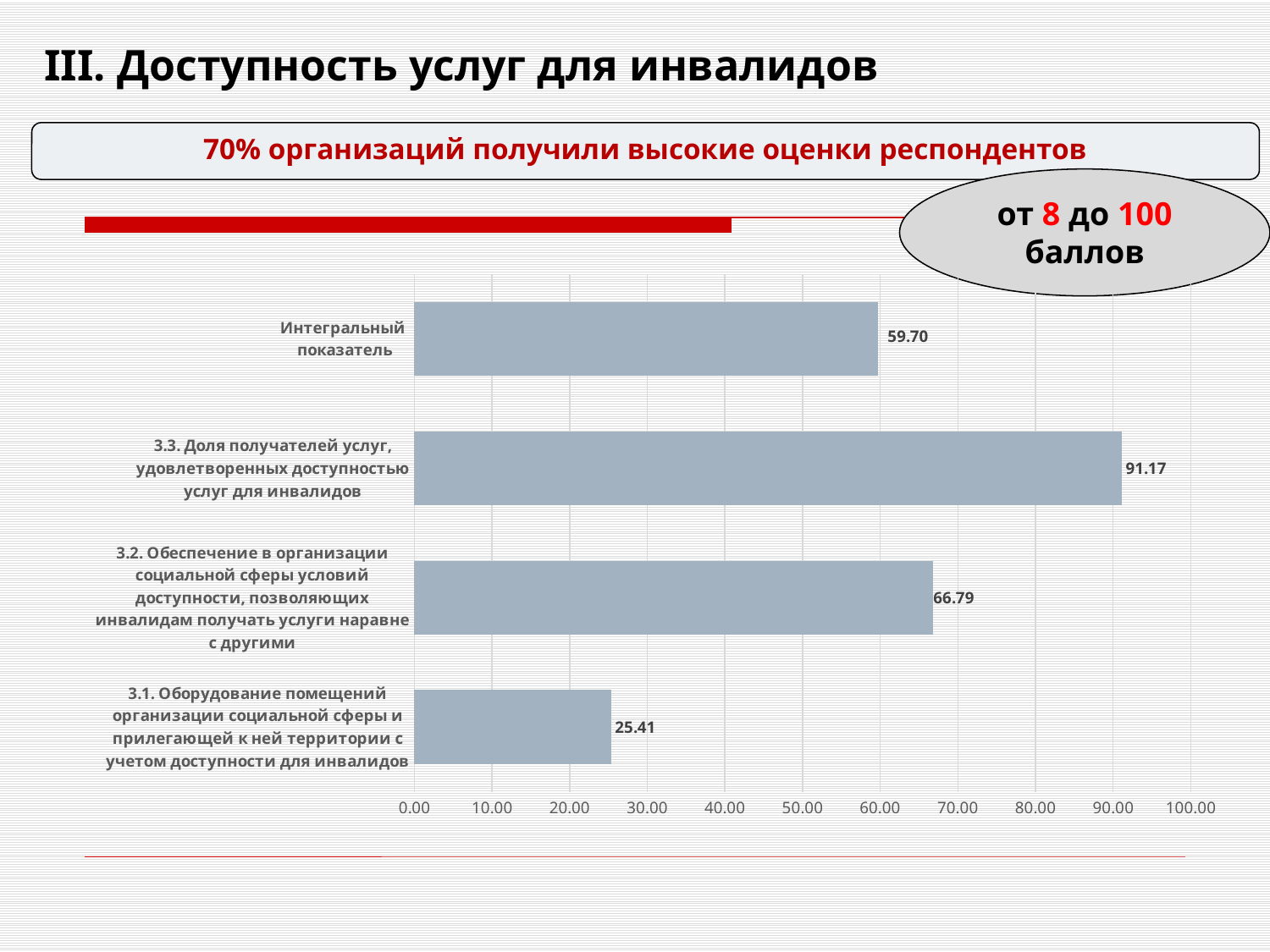
What is the value for "3.1. Оборудование помещений организации социальной сферы и прилегающей к ней территории с учетом доступности для инвалидов"? 25.41 What is the difference between the values for 3.2 and "Интегральный показатель"? 7.09 What is the value for "3.3. Доля получателей услуг, удовлетворенных доступностью услуг для инвалидов"? 91.17 Is the value for 3.1 greater or less than 30.00? less How many categories are shown in the chart? 4 Which is larger: the value for 3.2 or the value for "Интегральный показатель"? 3.2 What is the value for "Интегральный показатель"? 59.70 What is the value for "3.2. Обеспечение в организации социальной сферы условий доступности, позволяющих инвалидам получать услуги наравне с другими"? 66.79 What is the difference between the values for 3.3 and 3.1? 65.76 What kind of chart is shown on the slide? bar chart Which category has the lowest value? 3.1. Оборудование помещений организации социальной сферы и прилегающей к ней территории с учетом доступности для инвалидов Which category has the highest value? 3.3. Доля получателей услуг, удовлетворенных доступностью услуг для инвалидов